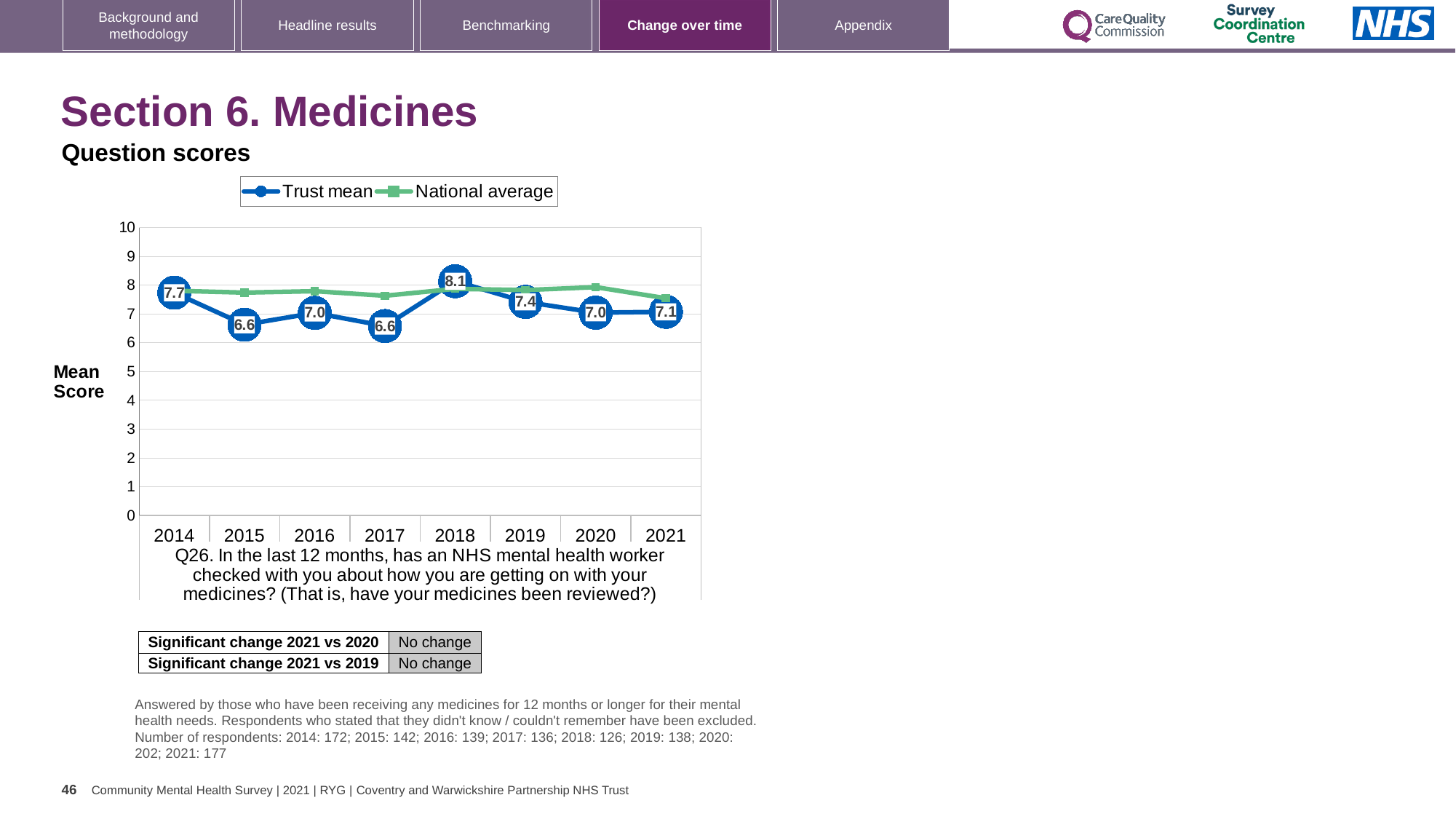
How many years are shown on the x axis of the chart? 8 What is the Trust mean score for 2021? 7.1 In which year is the Trust mean score highest? 2018 Is the National average value for 2014 greater or less than 7? greater Which is larger, the Trust mean score for 2019 or for 2020? 2019 What kind of chart is shown on the slide? Line chart What is the Trust mean score for 2014? 7.7 How many series does the legend list? 2 What is the difference between the Trust mean scores for 2018 and 2017? 1.5 What is the lowest Trust mean score shown on the chart? 6.6 What is the Trust mean score for 2018? 8.1 Did the Trust mean score rise or fall from 2014 to 2015? Fall